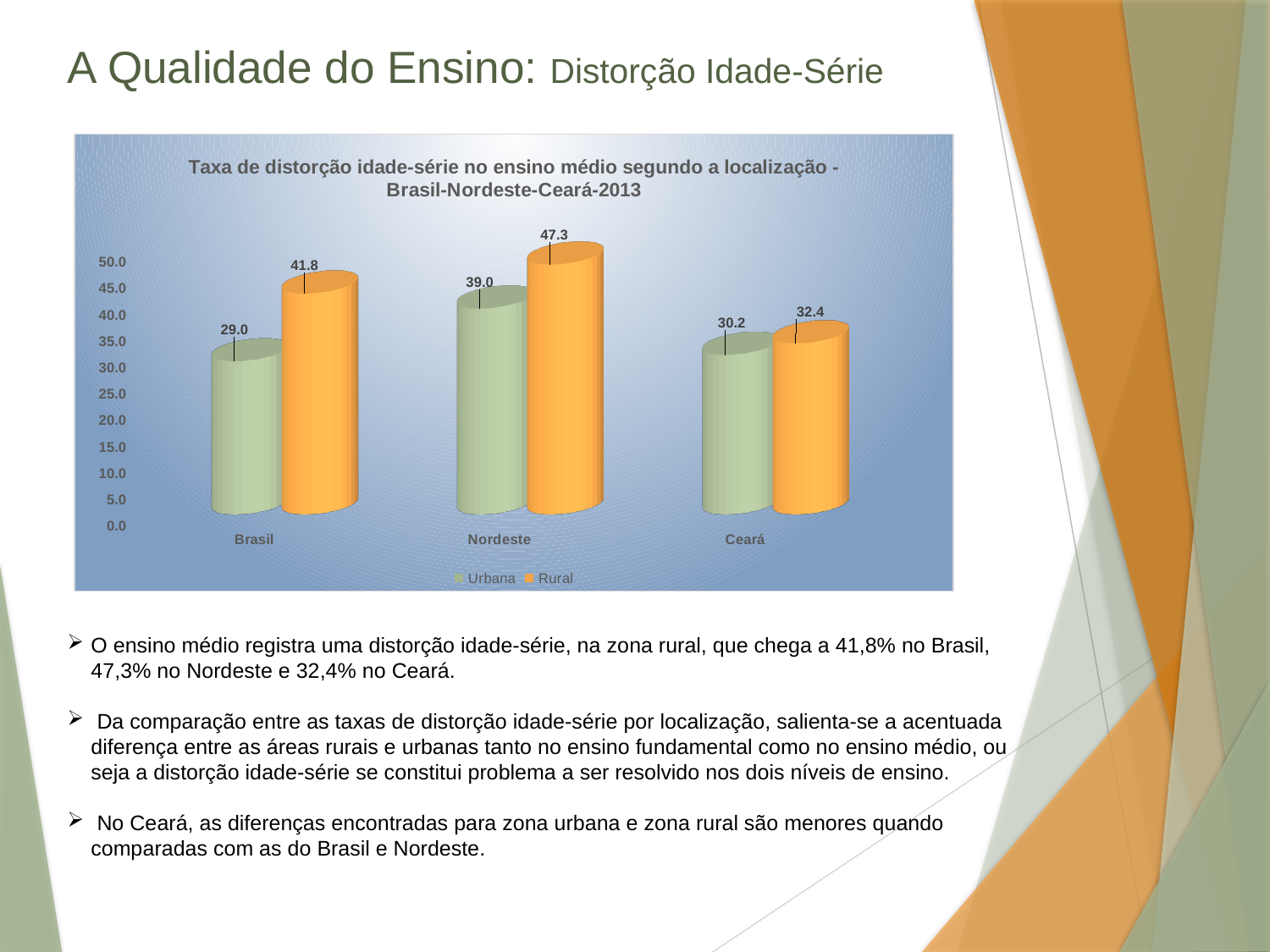
What is the Urbana value for Brasil? 29.0 What is the difference between the Rural and Urbana values for Brasil? 12.8 How many series does the legend list? 2 What kind of chart is shown? bar chart What is the difference between the Rural and Urbana values for Nordeste? 8.3 Which region has the lowest Urbana value? Brasil Is the Rural value for Brasil greater or less than 40.0? greater Which region has the highest Rural value? Nordeste What is the Rural value for Ceará? 32.4 What is the Rural value for Nordeste? 47.3 Which is larger, the Urbana value for Nordeste or the Urbana value for Ceará? Nordeste How many regions are shown on the x axis? 3